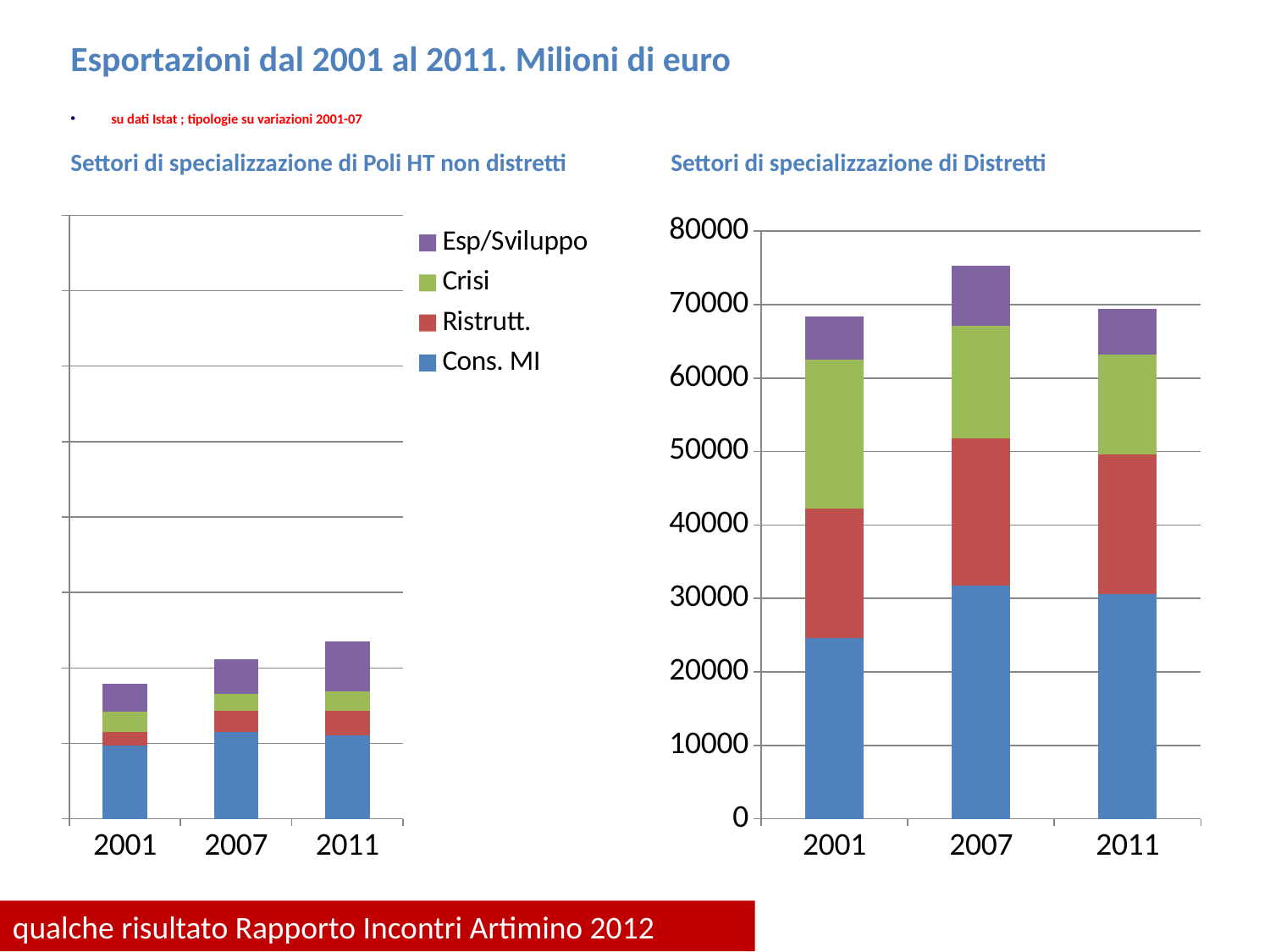
What kind of chart is the 'Settori di specializzazione di Distretti' chart on the right? Stacked bar chart In the right chart ('Settori di specializzazione di Distretti'), is the total stacked bar for 2001 greater or less than 70000? less Which series in the legend of the left chart is shown in purple? Esp/Sviluppo In the right chart ('Settori di specializzazione di Distretti'), is the Cons. MI (blue) segment for 2001 greater or less than 30000? less In the right chart ('Settori di specializzazione di Distretti'), which year has the tallest stacked bar? 2007 In the left chart ('Settori di specializzazione di Poli HT non distretti'), which year has the tallest stacked bar? 2011 In the left chart ('Settori di specializzazione di Poli HT non distretti'), which year has the shortest stacked bar? 2001 How many series does the legend of the left chart ('Settori di specializzazione di Poli HT non distretti') list? 4 In the left chart ('Settori di specializzazione di Poli HT non distretti'), do the total stacked bars rise or fall from 2001 to 2011? rise In the right chart ('Settori di specializzazione di Distretti'), is the total stacked bar for 2007 greater or less than 70000? greater How many year categories are shown on the x axis of the right chart ('Settori di specializzazione di Distretti')? 3 In the right chart ('Settori di specializzazione di Distretti'), which total stacked bar is larger, 2001 or 2007? 2007